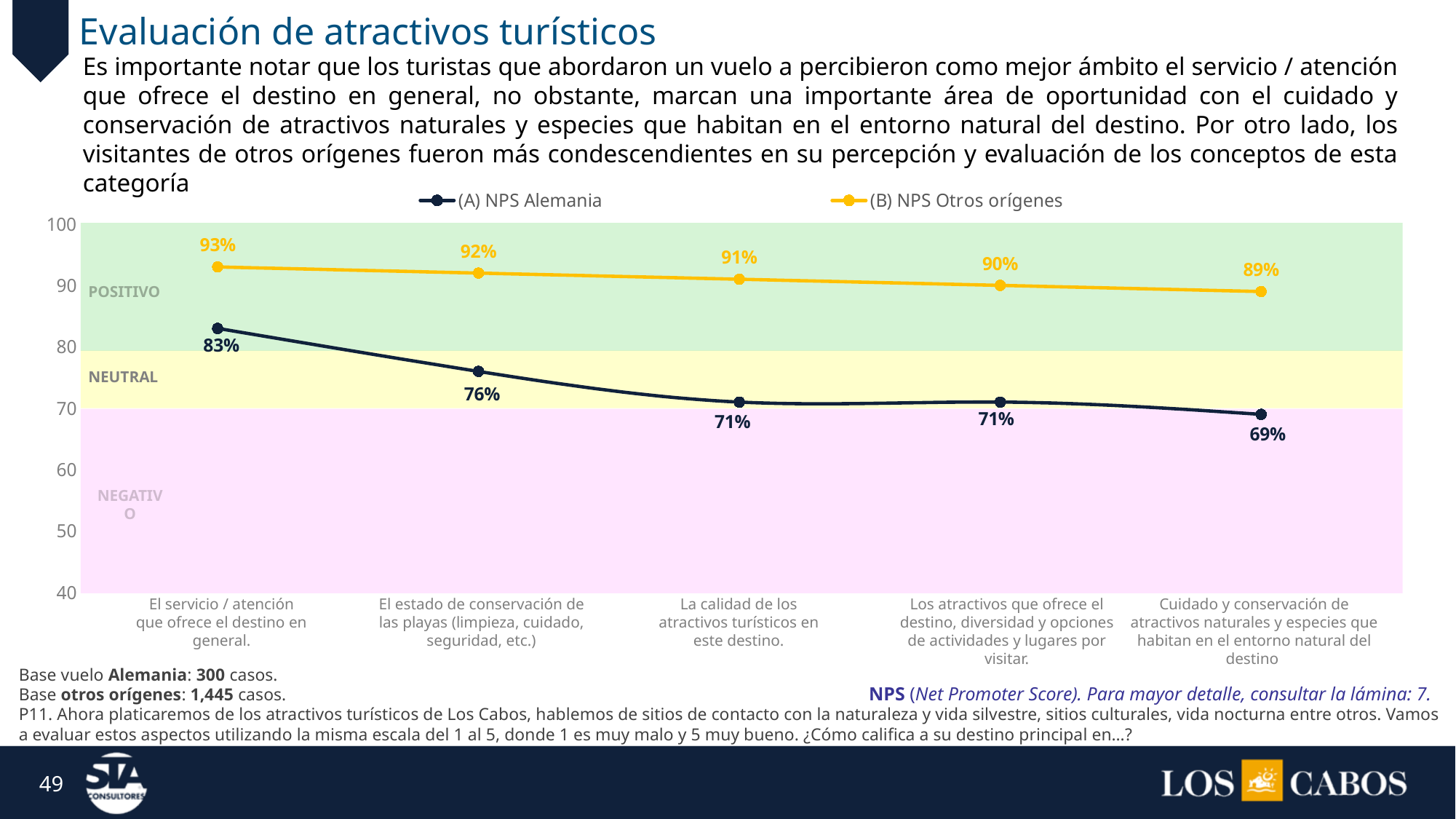
Is the (A) NPS Alemania value for 'Cuidado y conservación de atractivos naturales y especies que habitan en el entorno natural del destino' greater or less than 70? less What is the (A) NPS Alemania value for 'El servicio / atención que ofrece el destino en general.'? 83% Do the (B) NPS Otros orígenes values rise or fall from left to right across the categories? Fall How many series does the chart legend list? 2 What is the (B) NPS Otros orígenes value for 'Cuidado y conservación de atractivos naturales y especies que habitan en el entorno natural del destino'? 89% Which category has the highest (A) NPS Alemania value? El servicio / atención que ofrece el destino en general. How many categories are shown on the x axis of the chart? 5 What is the (A) NPS Alemania value for 'El estado de conservación de las playas (limpieza, cuidado, seguridad, etc.)'? 76% Which category has the lowest (B) NPS Otros orígenes value? Cuidado y conservación de atractivos naturales y especies que habitan en el entorno natural del destino What kind of chart is shown on the slide? Line chart What is the difference between the (B) NPS Otros orígenes and (A) NPS Alemania values for 'La calidad de los atractivos turísticos en este destino.'? 20% Which is larger for 'El estado de conservación de las playas (limpieza, cuidado, seguridad, etc.)': (A) NPS Alemania or (B) NPS Otros orígenes? (B) NPS Otros orígenes